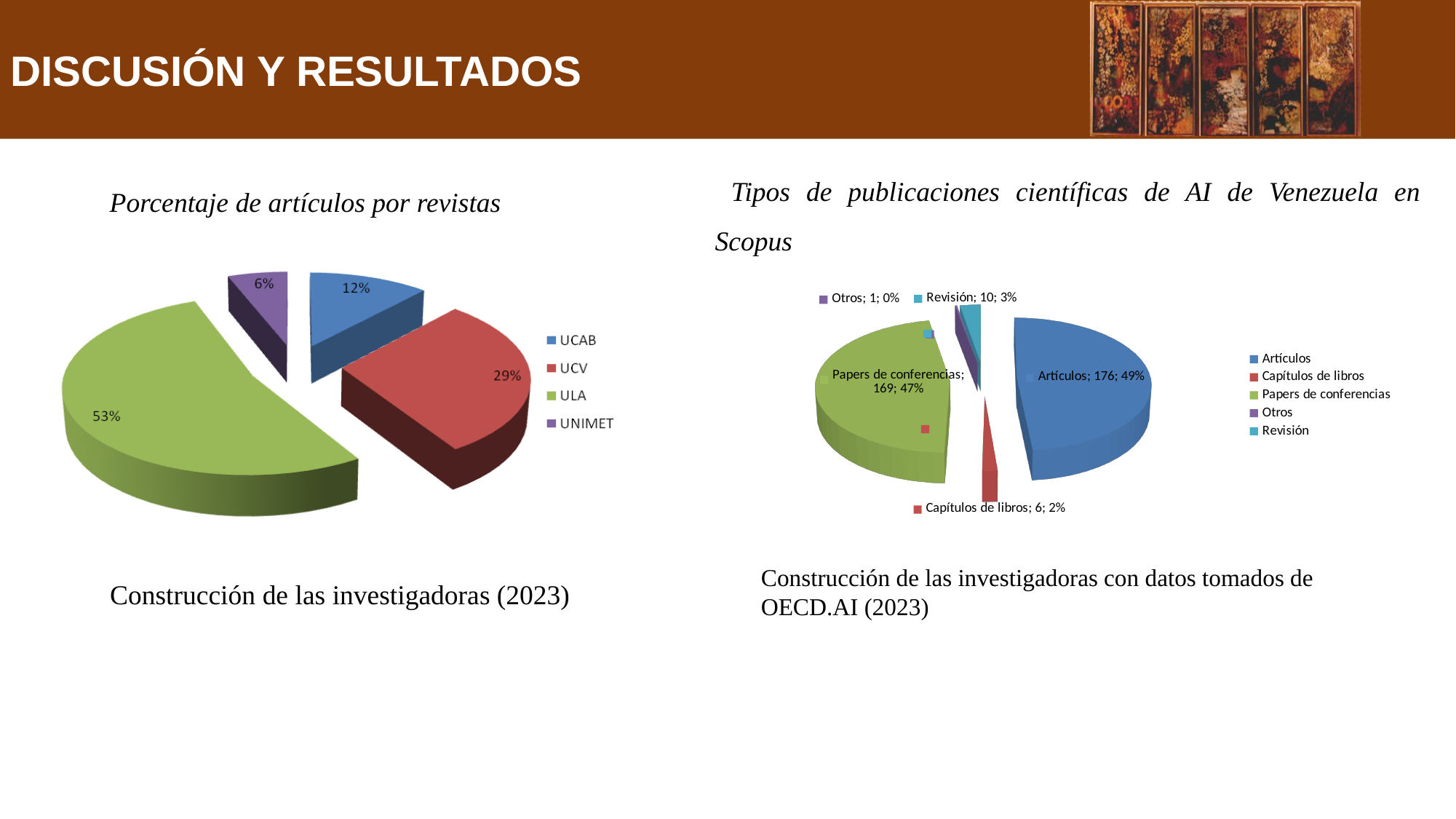
In the left chart 'Porcentaje de artículos por revistas', what percentage is shown for ULA? 53% In the left chart 'Porcentaje de artículos por revistas', what percentage is shown for UCV? 29% What type of chart is the right chart 'Tipos de publicaciones científicas de AI de Venezuela en Scopus'? Pie chart In the right chart 'Tipos de publicaciones científicas de AI de Venezuela en Scopus', what is the difference between the number of Artículos and Papers de conferencias? 7 In the right chart 'Tipos de publicaciones científicas de AI de Venezuela en Scopus', how many publications are Artículos? 176 In the right chart 'Tipos de publicaciones científicas de AI de Venezuela en Scopus', which is larger: Revisión or Capítulos de libros? Revisión In the left chart 'Porcentaje de artículos por revistas', which journal has the largest share? ULA In the right chart 'Tipos de publicaciones científicas de AI de Venezuela en Scopus', which category has the lowest count? Otros In the left chart 'Porcentaje de artículos por revistas', what is the difference in percentage points between ULA and UCAB? 41 In the right chart 'Tipos de publicaciones científicas de AI de Venezuela en Scopus', what share of the pie is Papers de conferencias? 47% In the left chart 'Porcentaje de artículos por revistas', how many categories does the legend list? 4 In the left chart 'Porcentaje de artículos por revistas', which journal has the smallest share? UNIMET